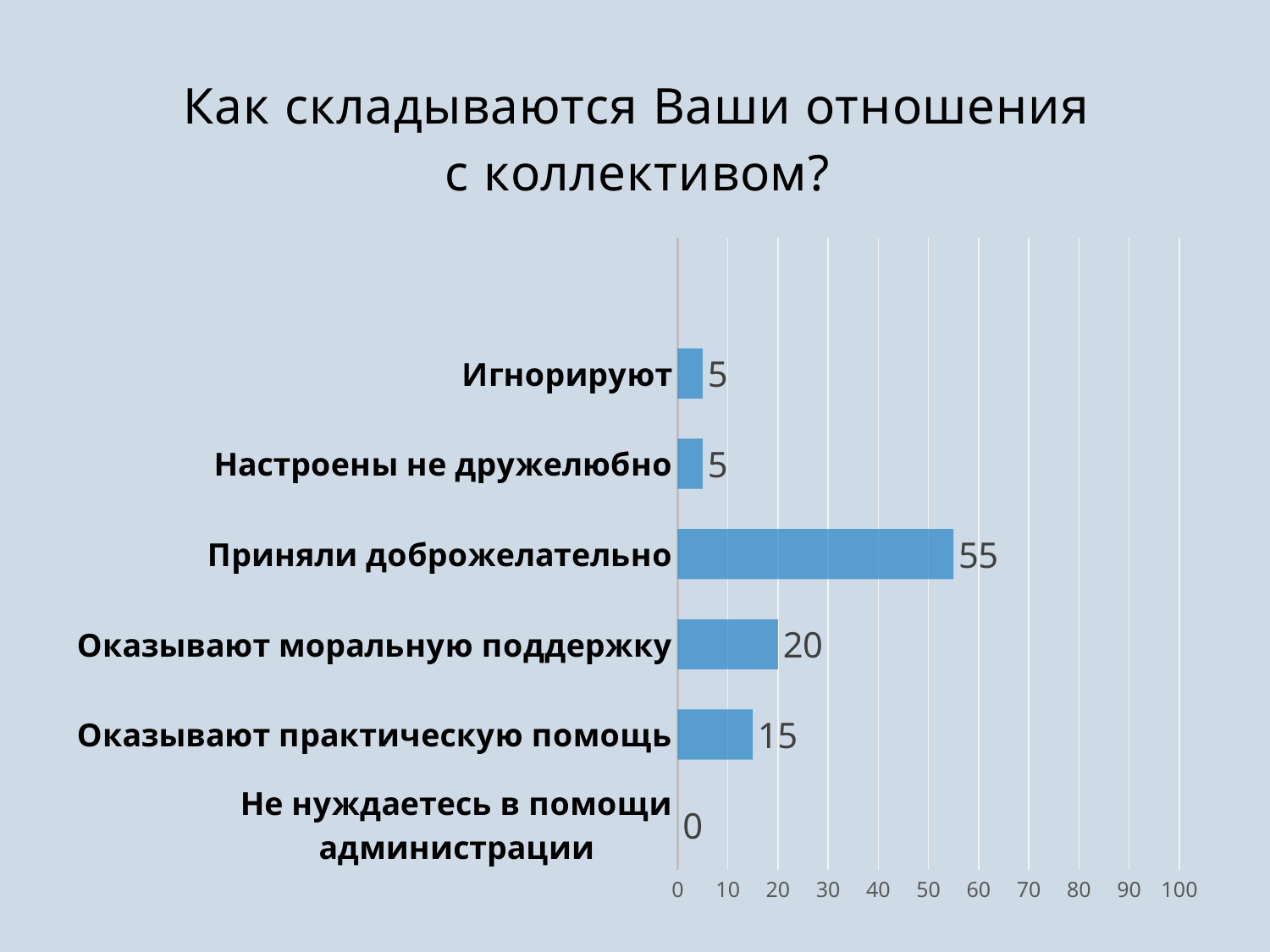
What value is shown for "Оказывают практическую помощь"? 15 What value is shown for "Приняли доброжелательно"? 55 Is the value for "Приняли доброжелательно" greater or less than 50? greater What is the title of the chart? Как складываются Ваши отношения с коллективом? How many categories are shown in the chart? 6 Which category has the lowest value? Не нуждаетесь в помощи администрации What value is shown for "Не нуждаетесь в помощи администрации"? 0 What is the difference between the values for "Приняли доброжелательно" and "Оказывают моральную поддержку"? 35 Which is larger: the value for "Оказывают моральную поддержку" or for "Оказывают практическую помощь"? Оказывают моральную поддержку What value is shown for "Оказывают моральную поддержку"? 20 Which category has the highest value? Приняли доброжелательно What kind of chart is shown on the slide? bar chart